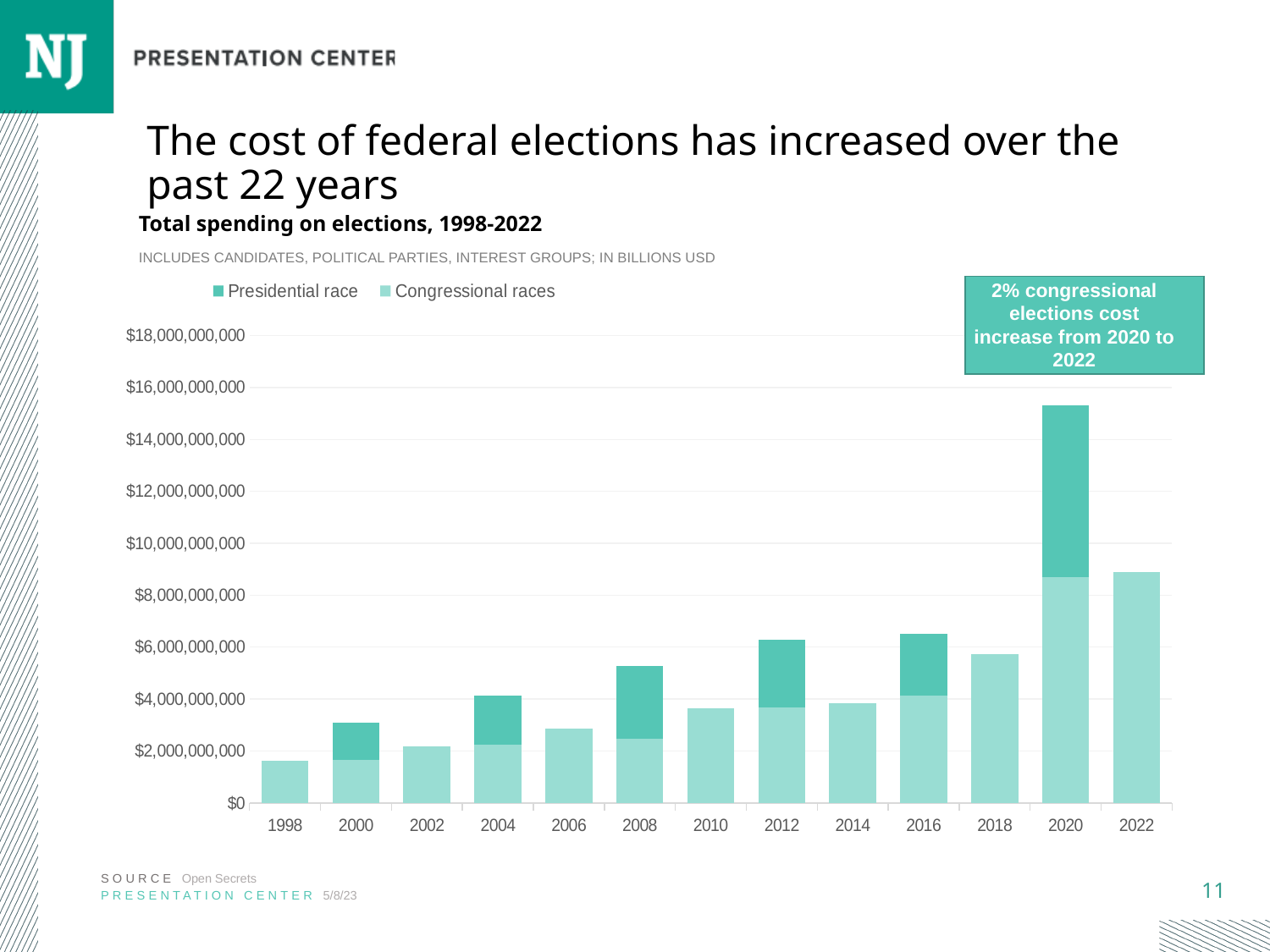
Which year has the shortest bar (lowest total spending)? 1998 How many bars include a Presidential race segment? 6 How many series does the legend list? 2 Is the total spending for 2022 greater or less than $8,000,000,000? greater What kind of chart is shown on the slide? Stacked bar chart Which year has the larger total bar, 2012 or 2014? 2012 What are the two series named in the legend? Presidential race and Congressional races Is the total spending for 1998 greater or less than $2,000,000,000? less Is the total spending for 2020 greater or less than $14,000,000,000? greater Which year has the tallest bar (highest total spending)? 2020 How many years (bars) are plotted on the x axis? 13